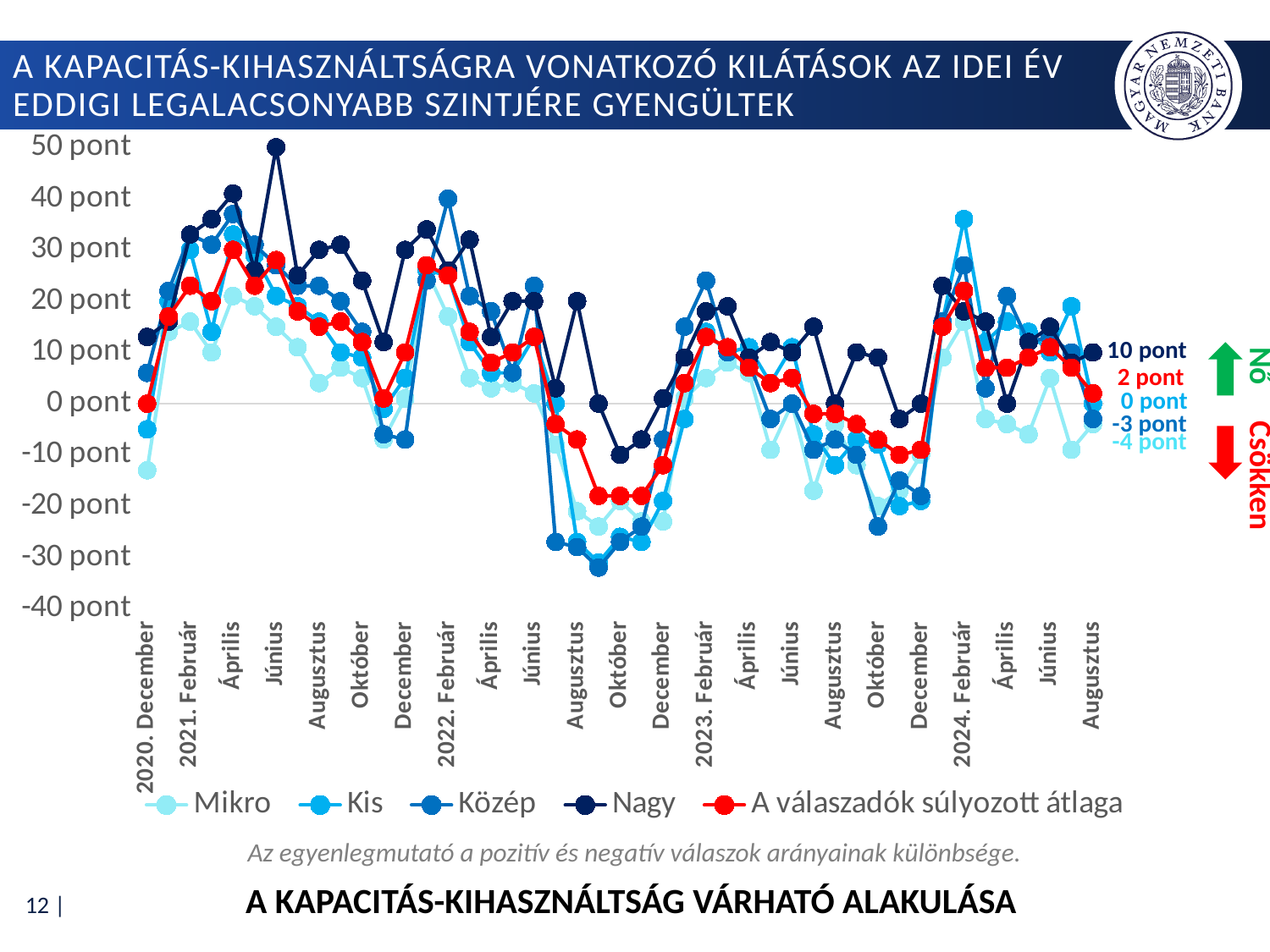
What is the title of the chart shown at the bottom of the slide? A KAPACITÁS-KIHASZNÁLTSÁG VÁRHATÓ ALAKULÁSA What is the difference between the latest Nagy value and the latest Mikro value? 14 pont What is the latest value shown for the Közép series? -3 pont At the last data point, which is larger: the Kis value or the Közép value? Kis Is the value for Nagy in June 2021 greater or less than 40 pont? greater What is the latest value shown for the Mikro series? -4 pont What is the latest (August 2024) value shown for the Nagy series? 10 pont What is the latest value shown for the Kis series? 0 pont How many series does the legend list? 5 Which series has the highest value at the last data point (August 2024)? Nagy What kind of chart is shown on the slide? line chart What is the latest value shown for 'A válaszadók súlyozott átlaga'? 2 pont